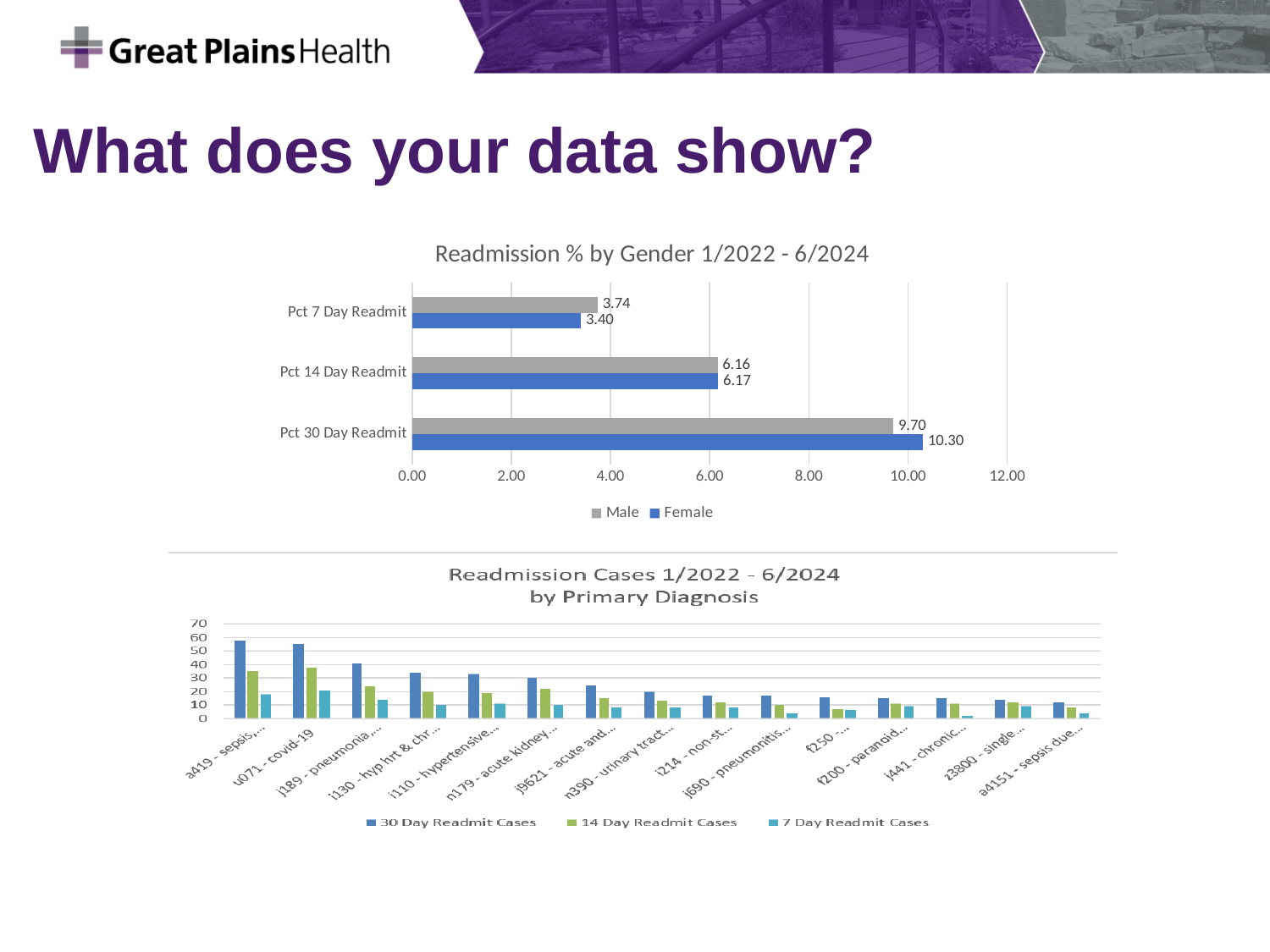
In the Readmission % by Gender chart, what is the difference between the Female and Male values for Pct 30 Day Readmit? 0.60 In the Readmission Cases by Primary Diagnosis chart, is the 30 Day Readmit Cases value for a419 - sepsis greater or less than 50? greater In the Readmission % by Gender chart, what is the Female value for Pct 7 Day Readmit? 3.40 How many series does the legend of the Readmission % by Gender chart list? 2 In the Readmission % by Gender chart, what is the Female value for Pct 14 Day Readmit? 6.17 In the Readmission Cases by Primary Diagnosis chart, do the 30 Day Readmit Cases values generally rise or fall from left to right? Fall In the Readmission % by Gender chart, which is larger for Pct 7 Day Readmit, the Male or the Female value? Male In the Readmission % by Gender chart, what is the Male value for Pct 30 Day Readmit? 9.70 How many series does the legend of the Readmission Cases by Primary Diagnosis chart list? 3 What kind of chart is the Readmission Cases by Primary Diagnosis chart? Bar chart In the Readmission % by Gender chart, which category has the lowest Male value? Pct 7 Day Readmit In the Readmission % by Gender chart, which category has the highest Female value? Pct 30 Day Readmit